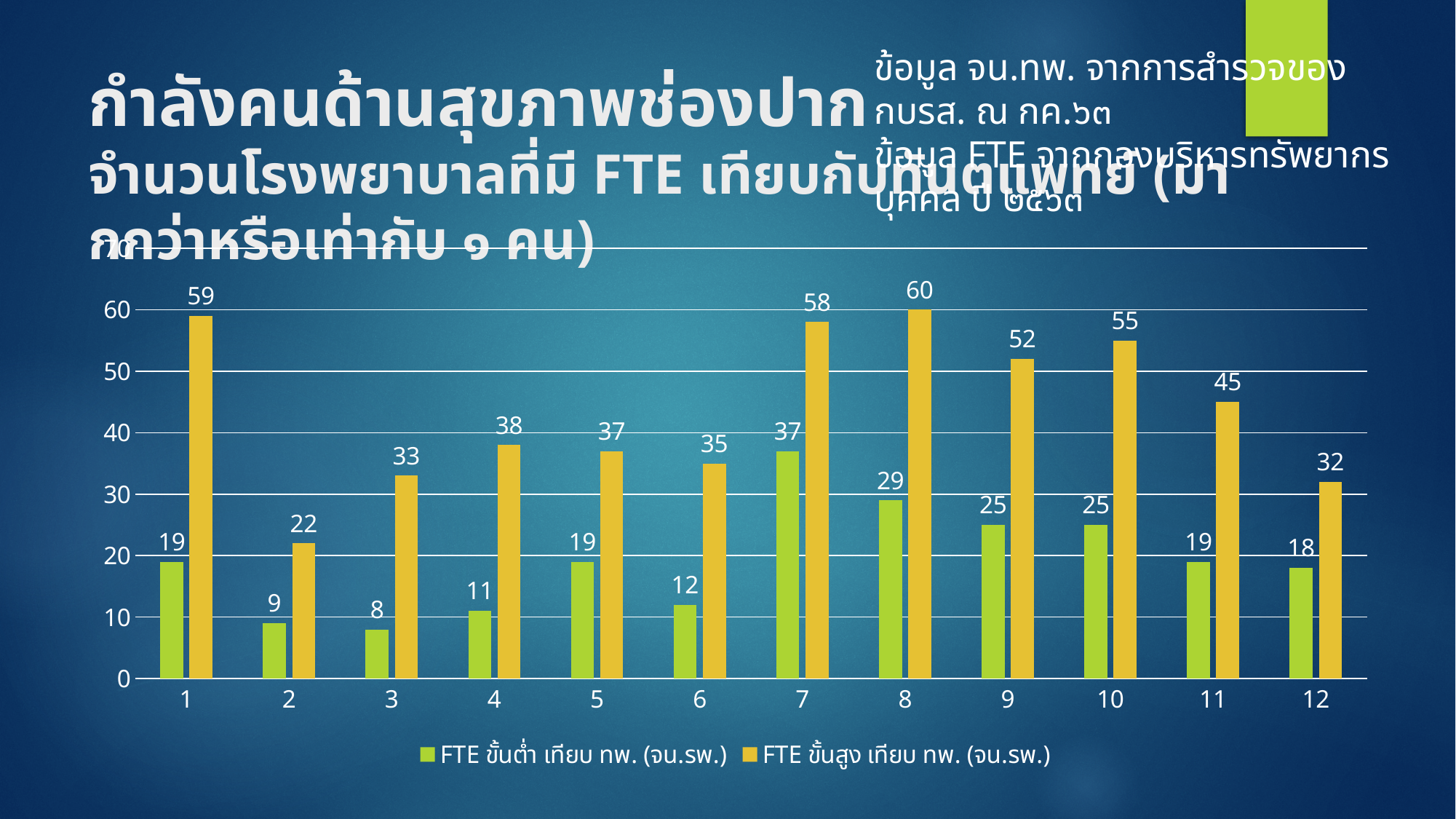
What is the value of FTE ขั้นต่ำ เทียบ ทพ. (จน.รพ.) for category 3? 8 How many series does the legend list? 2 What is the value of FTE ขั้นสูง เทียบ ทพ. (จน.รพ.) for category 1? 59 Which category has the lowest value for FTE ขั้นสูง เทียบ ทพ. (จน.รพ.)? 2 What is the difference between FTE ขั้นสูง and FTE ขั้นต่ำ for category 8? 31 What is the value of FTE ขั้นต่ำ เทียบ ทพ. (จน.รพ.) for category 7? 37 Which is larger for category 12: FTE ขั้นต่ำ เทียบ ทพ. (จน.รพ.) or FTE ขั้นสูง เทียบ ทพ. (จน.รพ.)? FTE ขั้นสูง เทียบ ทพ. (จน.รพ.) What colour are the bars for FTE ขั้นสูง เทียบ ทพ. (จน.รพ.)? yellow What type of chart is shown on the slide? bar chart How many categories are shown on the x axis? 12 Which category has the lowest value for FTE ขั้นต่ำ เทียบ ทพ. (จน.รพ.)? 3 Which category has the highest value for FTE ขั้นสูง เทียบ ทพ. (จน.รพ.)? 8